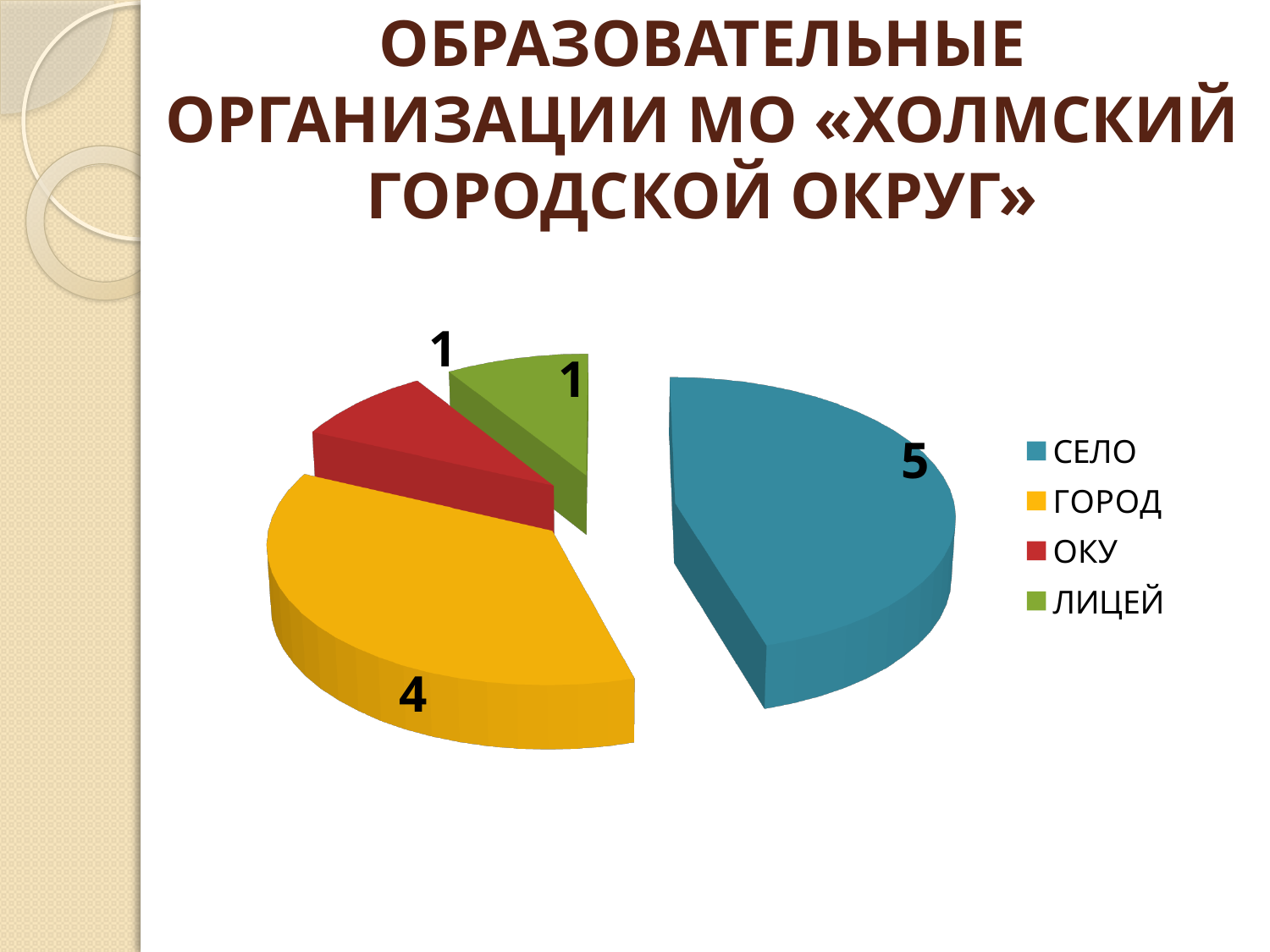
What is the value for ОКУ? 1 What is the value for ЛИЦЕЙ? 1 What is the total of all the slices in the pie chart? 11 How many categories does the pie chart have? 4 Which category has the largest slice? СЕЛО What kind of chart is shown on the slide? Pie chart What is the value for СЕЛО? 5 What is the difference between the values for СЕЛО and ГОРОД? 1 Which is larger, the value for ГОРОД or the value for ЛИЦЕЙ? ГОРОД What is the value for ГОРОД? 4 What is the difference between the values for ГОРОД and ОКУ? 3 Which two categories share the smallest value? ОКУ and ЛИЦЕЙ